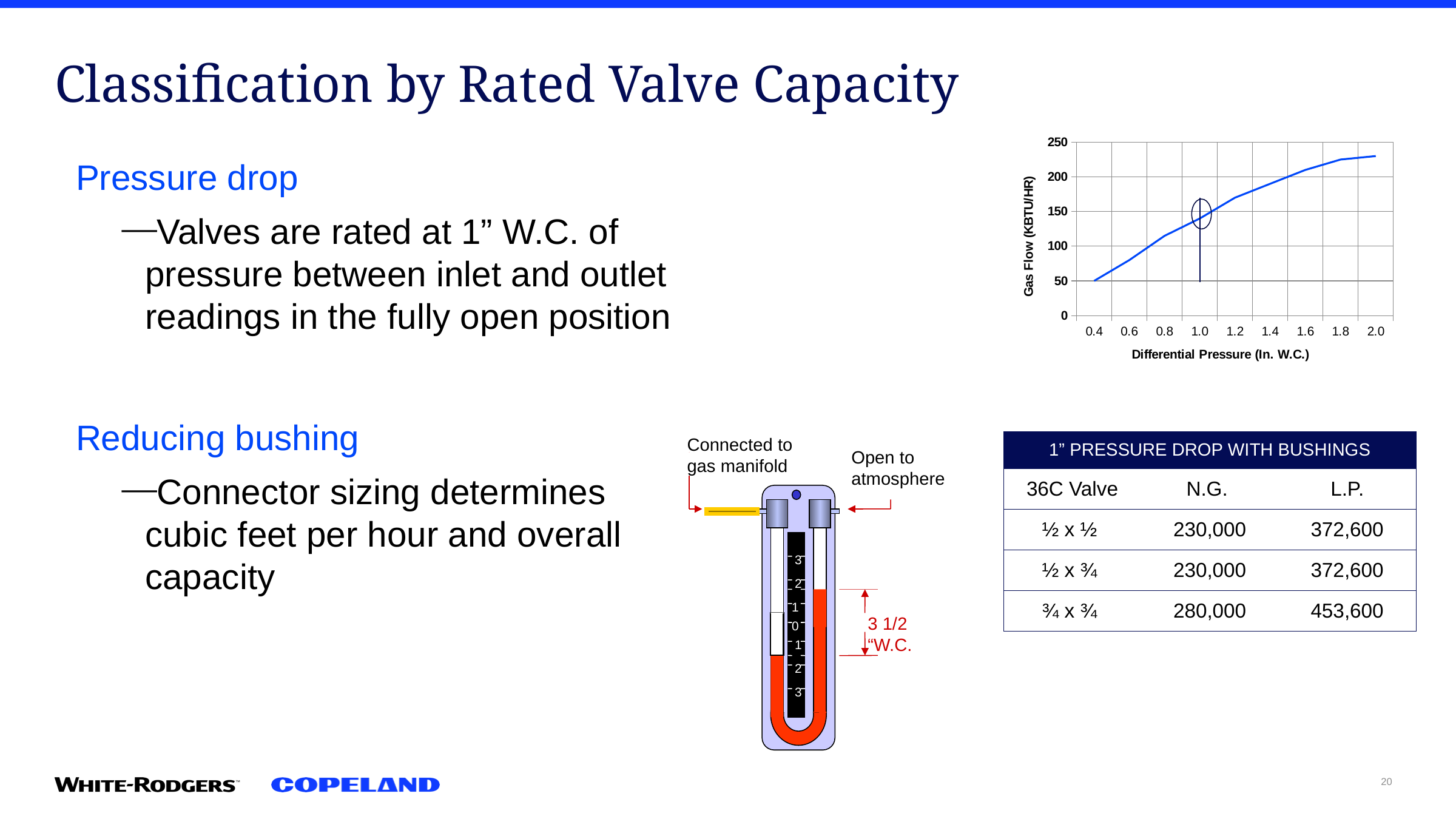
In the Gas Flow chart, which has the larger gas flow: a differential pressure of 0.8 or 1.8? 1.8 How many tick labels are shown on the x axis of the Gas Flow chart? 9 In the Gas Flow chart, is the gas flow at a differential pressure of 1.0 greater or less than 100? greater In the Gas Flow chart, at which differential pressure on the x axis is the gas flow highest? 2.0 In the Gas Flow chart, is the gas flow at a differential pressure of 1.6 greater or less than 150? greater In the Gas Flow chart, at which differential pressure on the x axis is the gas flow lowest? 0.4 In the Gas Flow chart, is the gas flow at a differential pressure of 0.4 greater or less than 100? less In the Gas Flow chart, do the values rise or fall as differential pressure increases along the x axis? rise What is the title of the y axis of the chart in the top right of the slide? Gas Flow (KBTU/HR) What kind of chart is shown in the top right of the slide? line chart